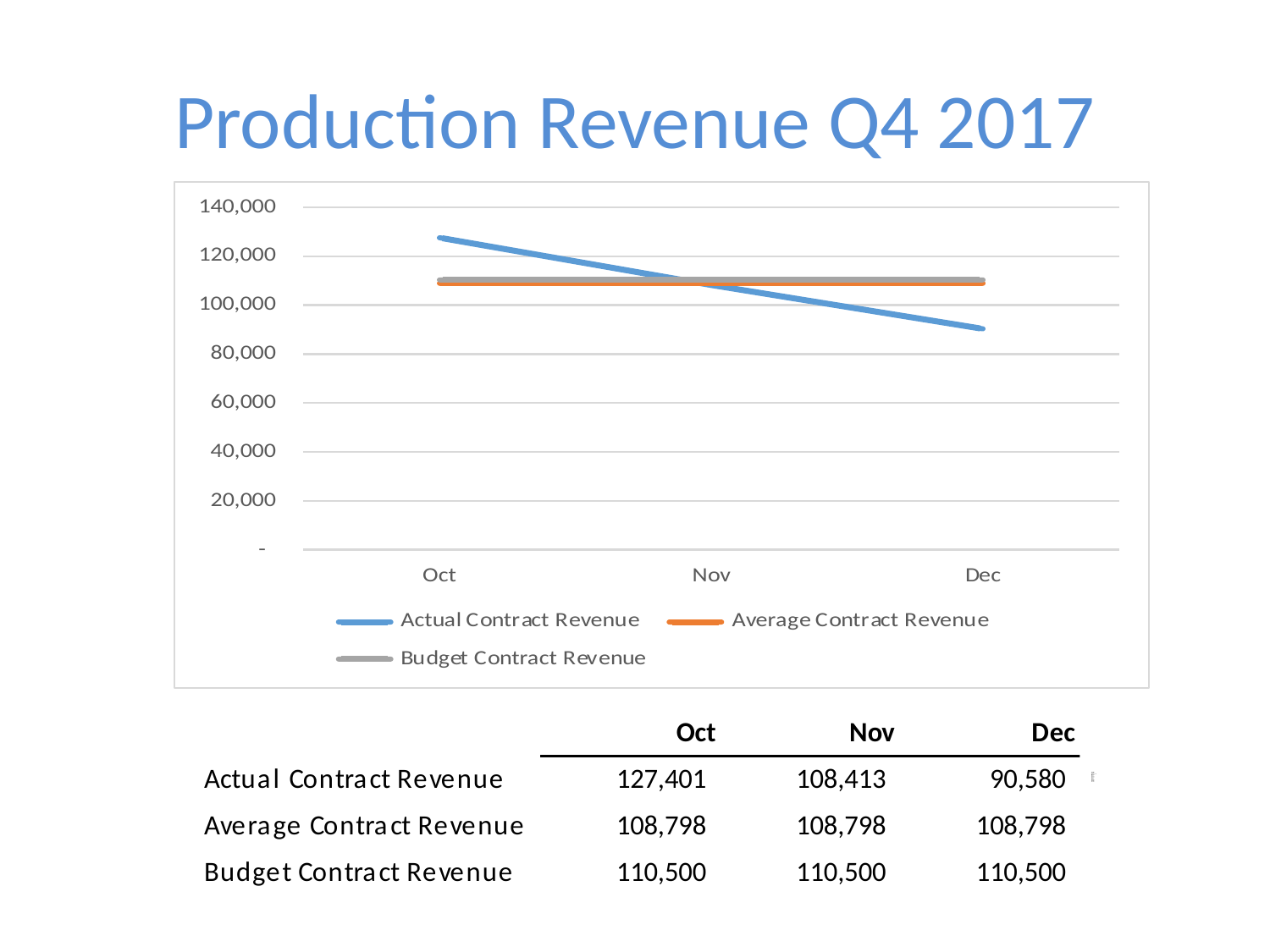
How many series does the legend list? 3 In which month is Actual Contract Revenue highest? Oct What kind of chart is shown on the slide? line chart What is the difference between Actual Contract Revenue in Oct and in Dec? 36,821 Is the Actual Contract Revenue for Dec greater or less than 100,000? less Does Actual Contract Revenue rise or fall from Oct to Dec? fall What is the Average Contract Revenue for Oct? 108,798 What is the Actual Contract Revenue for Dec? 90,580 Which is larger in Oct, Actual Contract Revenue or Budget Contract Revenue? Actual Contract Revenue What is the Actual Contract Revenue for Oct? 127,401 In which month is Actual Contract Revenue lowest? Dec What is the Budget Contract Revenue for Nov? 110,500